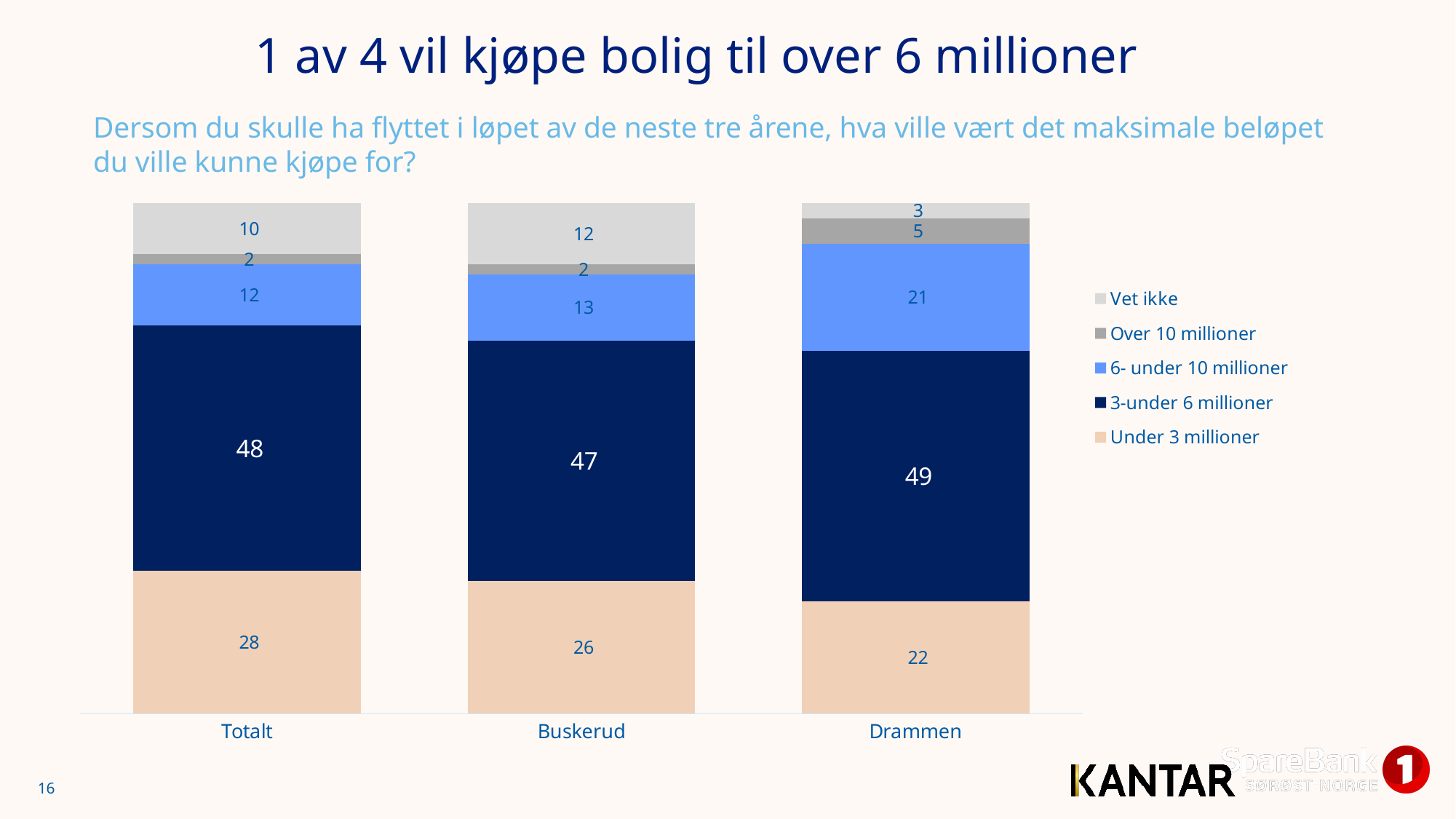
What is the total of the stacked bar for Drammen? 100 What is the difference between the 'Vet ikke' values for Buskerud and Drammen? 9 How many categories are shown on the x axis? 3 What is the value for 'Vet ikke' in Totalt? 10 What is the value for 'Under 3 millioner' in Buskerud? 26 Which category has the lowest value for 'Under 3 millioner'? Drammen How many series does the legend list? 5 What is the value for 'Over 10 millioner' in Drammen? 5 What kind of chart is shown on the slide? Stacked bar chart What is the value for '3-under 6 millioner' in Drammen? 49 Which category has the highest value for '6- under 10 millioner'? Drammen Which is larger: the 'Under 3 millioner' value for Totalt or for Buskerud? Totalt